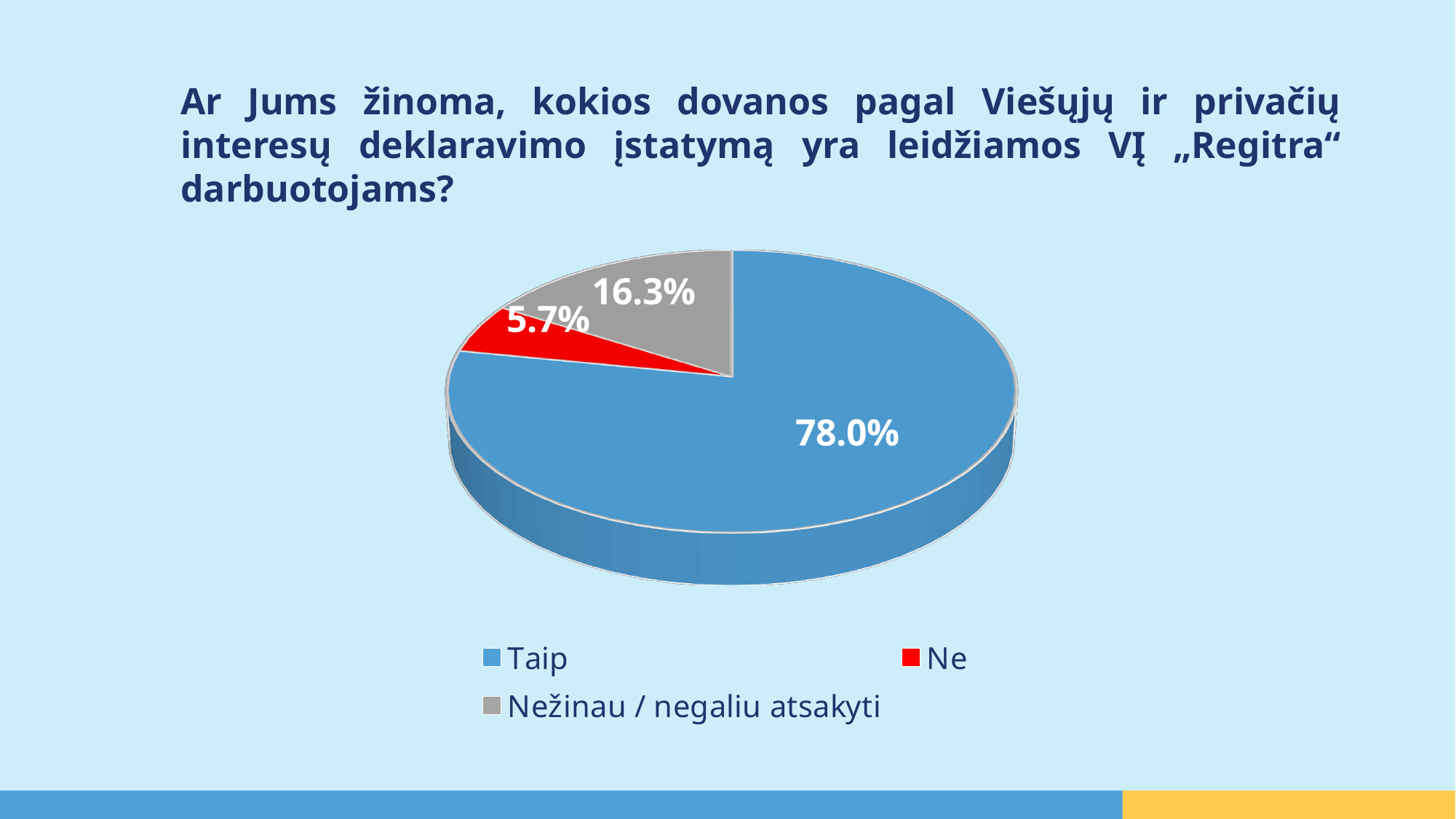
How many slices does the pie chart have? 3 How many entries does the legend list? 3 What is the difference in percentage points between "Taip" and "Nežinau / negaliu atsakyti"? 61.7 What percentage of respondents answered "Nežinau / negaliu atsakyti"? 16.3% What percentage of respondents answered "Ne"? 5.7% What kind of chart is shown on the slide? Pie chart Which is larger, the share for "Ne" or the share for "Nežinau / negaliu atsakyti"? Nežinau / negaliu atsakyti What percentage of respondents answered "Taip"? 78.0% What is the difference in percentage points between "Nežinau / negaliu atsakyti" and "Ne"? 10.6 Which answer has the largest share of the pie? Taip What colour is the slice for "Ne"? Red Which answer has the smallest share of the pie? Ne